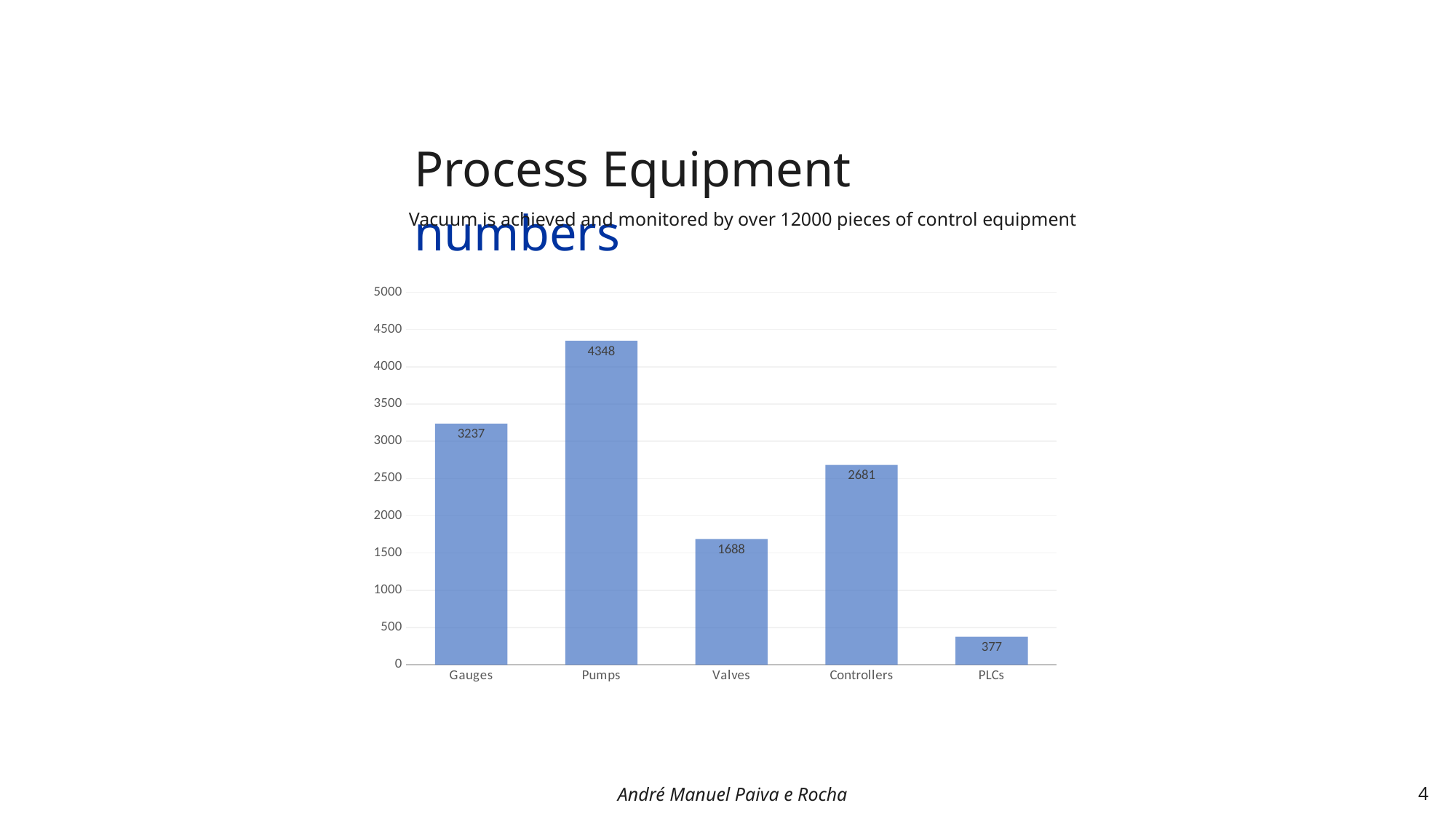
What is the value for Gauges? 3237 What is the value for Pumps? 4348 How many categories are shown on the x axis? 5 What is the difference between the values for Controllers and Valves? 993 What is the difference between the values for Pumps and Gauges? 1111 What is the value for Valves? 1688 What is the value for PLCs? 377 Which is larger, the value for Controllers or the value for Valves? Controllers Is the value for Controllers greater or less than 2500? greater Which category has the highest value? Pumps Which category has the lowest value? PLCs What kind of chart is shown on the slide? bar chart